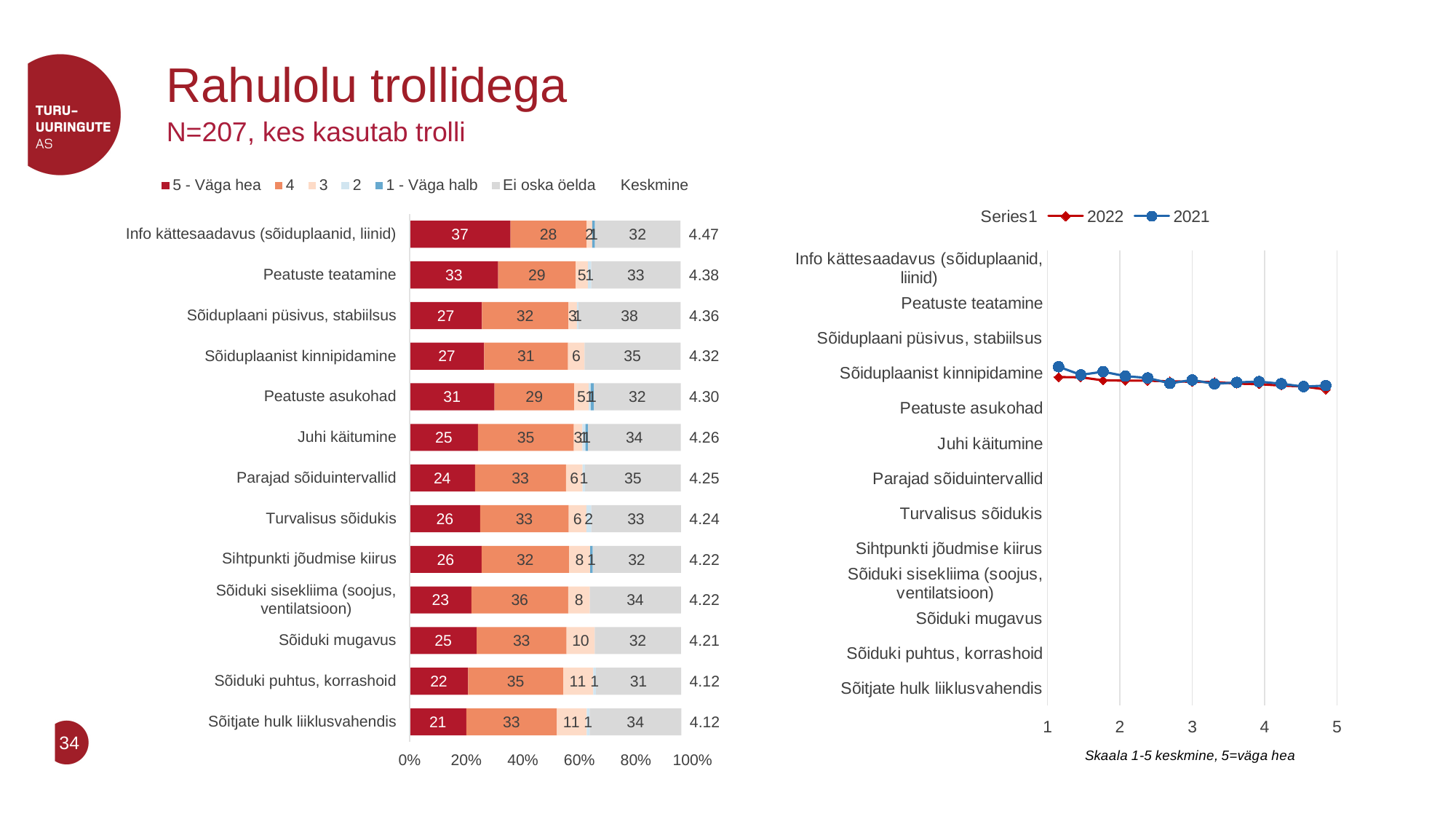
In the left stacked bar chart, which category has the lowest '5 - Väga hea' share? Sõitjate hulk liiklusvahendis In the left stacked bar chart, which has a larger 'Ei oska öelda' value: Sõiduplaani püsivus, stabiilsus or Sõiduplaanist kinnipidamine? Sõiduplaani püsivus, stabiilsus What type of chart is the chart on the left of the slide? Stacked bar chart What is the range of the x axis on the right-hand line chart? 1 to 5 How many categories are shown in the left stacked bar chart? 13 In the left stacked bar chart, what is the Keskmine value for Info kättesaadavus (sõiduplaanid, liinid)? 4.47 In the left stacked bar chart, do the Keskmine values increase or decrease going from the top category to the bottom category? Decrease In the left stacked bar chart, what is the difference between the Keskmine values of Info kättesaadavus (sõiduplaanid, liinid) and Sõitjate hulk liiklusvahendis? 0.35 In the left stacked bar chart, what percentage gave '5 - Väga hea' for Sõiduki sisekliima (soojus, ventilatsioon)? 23 In the left stacked bar chart, what is the 'Ei oska öelda' value for Sõiduplaani püsivus, stabiilsus? 38 What entries does the legend of the right-hand line chart list? Series1, 2022, 2021 In the left stacked bar chart, which category has the highest Keskmine value? Info kättesaadavus (sõiduplaanid, liinid)